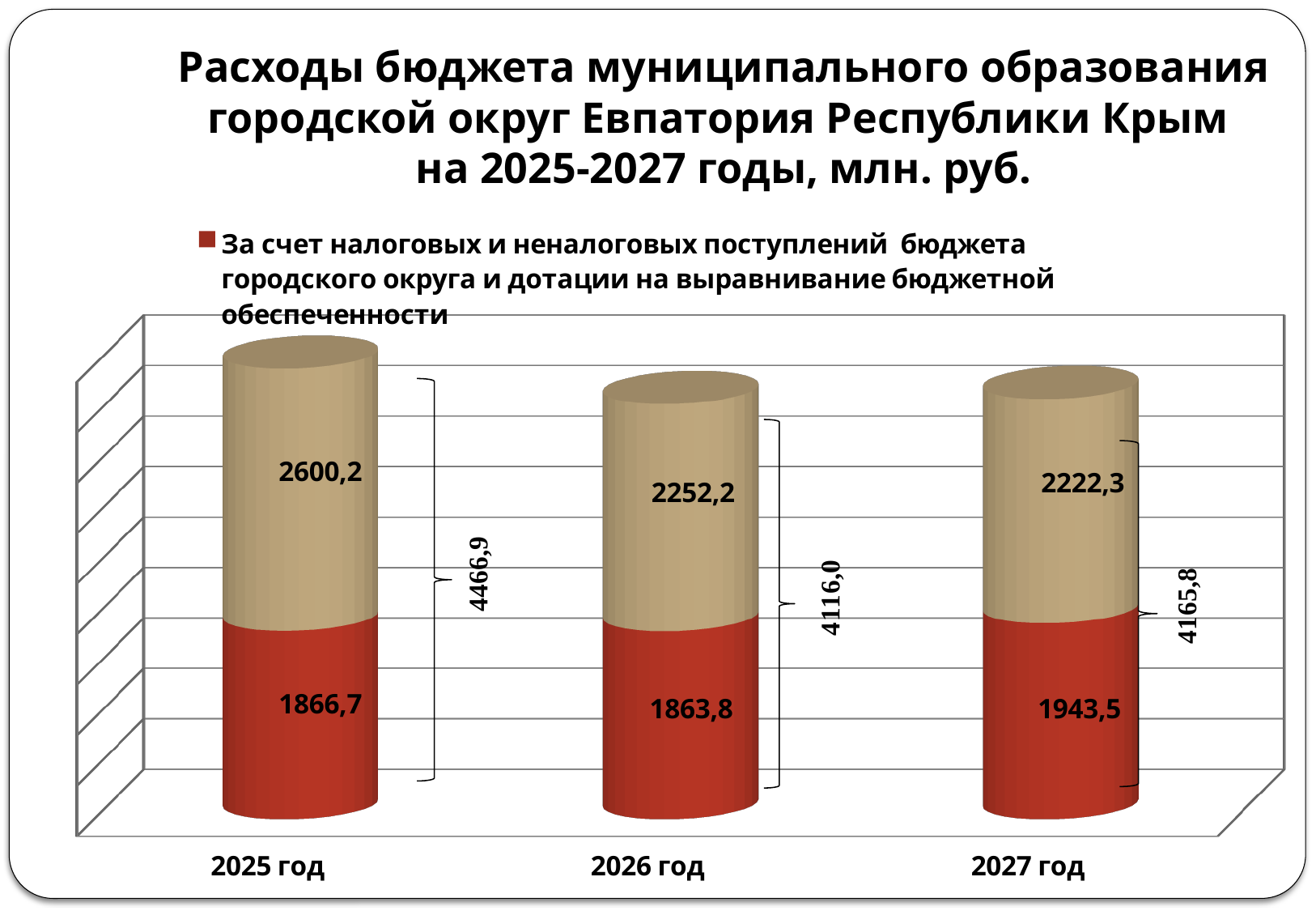
Which is larger: the red segment for 2027 год or the red segment for 2025 год? 2027 год What kind of chart is shown on the slide? Stacked bar chart What is the difference between the upper (tan) segment for 2025 год and the upper segment for 2027 год? 377,9 What is the difference between the total for 2025 год and the total for 2026 год? 350,9 Which year has the highest total expenditure? 2025 год What total is shown beside the bar for 2027 год? 4165,8 What is the value of the upper (tan) segment for 2026 год? 2252,2 What is the total of the stacked bar for 2025 год? 4466,9 How many years (categories) are shown on the x axis? 3 Does the upper (tan) segment rise or fall from 2025 год to 2027 год? Fall Which year has the lowest total expenditure? 2026 год What is the value of the red (lower) segment for 2025 год? 1866,7